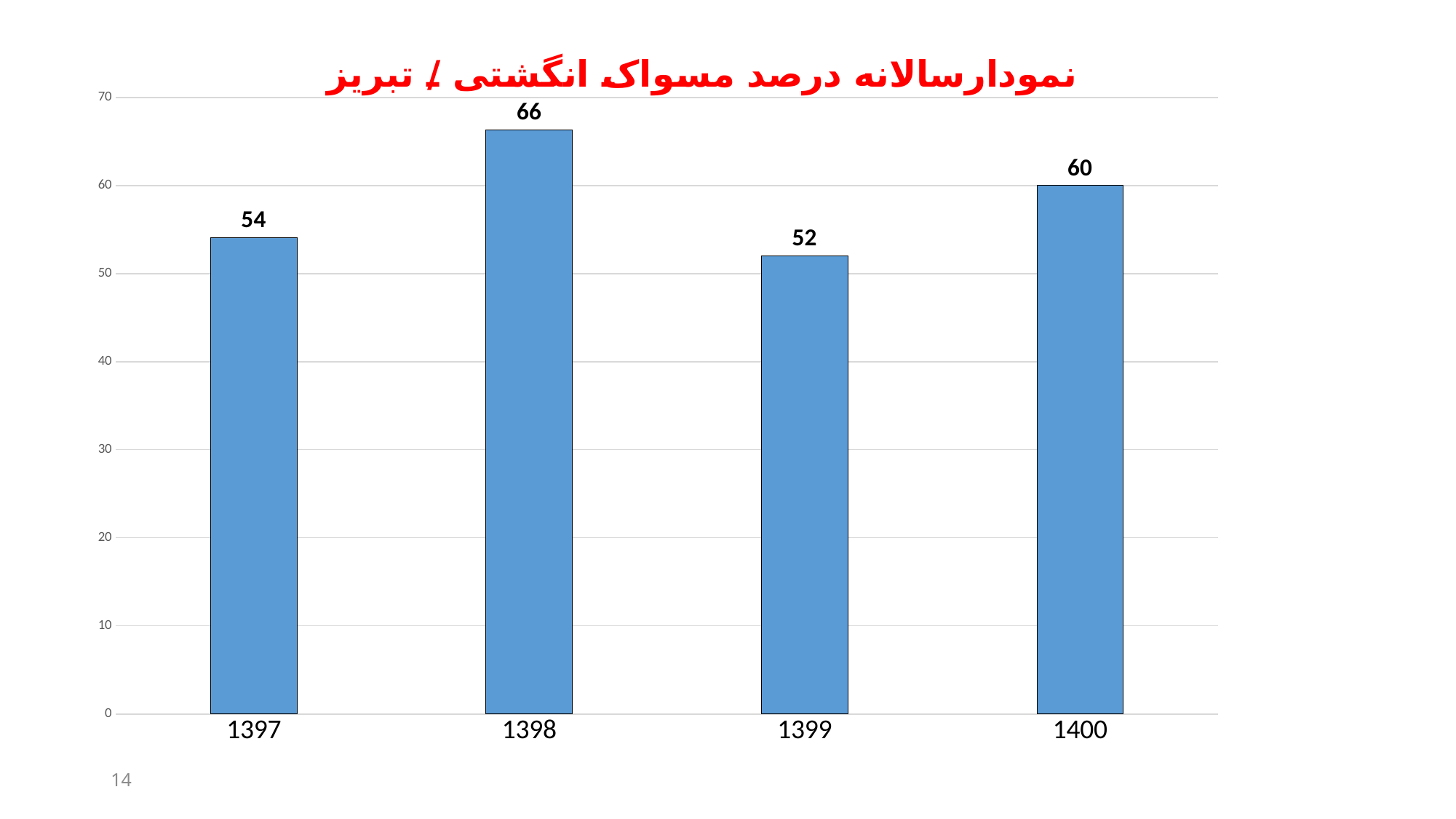
How many years are shown on the x axis? 4 Which year has the highest value? 1398 What is the value for 1399? 52 What is the difference between the values for 1398 and 1399? 14 What kind of chart is shown on the slide? bar chart What is the value for 1398? 66 Which year has the lowest value? 1399 What is the value for 1400? 60 Which is larger, the value for 1397 or the value for 1400? 1400 Is the value for 1398 greater or less than 60? greater What colour are the bars in the chart? blue What is the value for 1397? 54